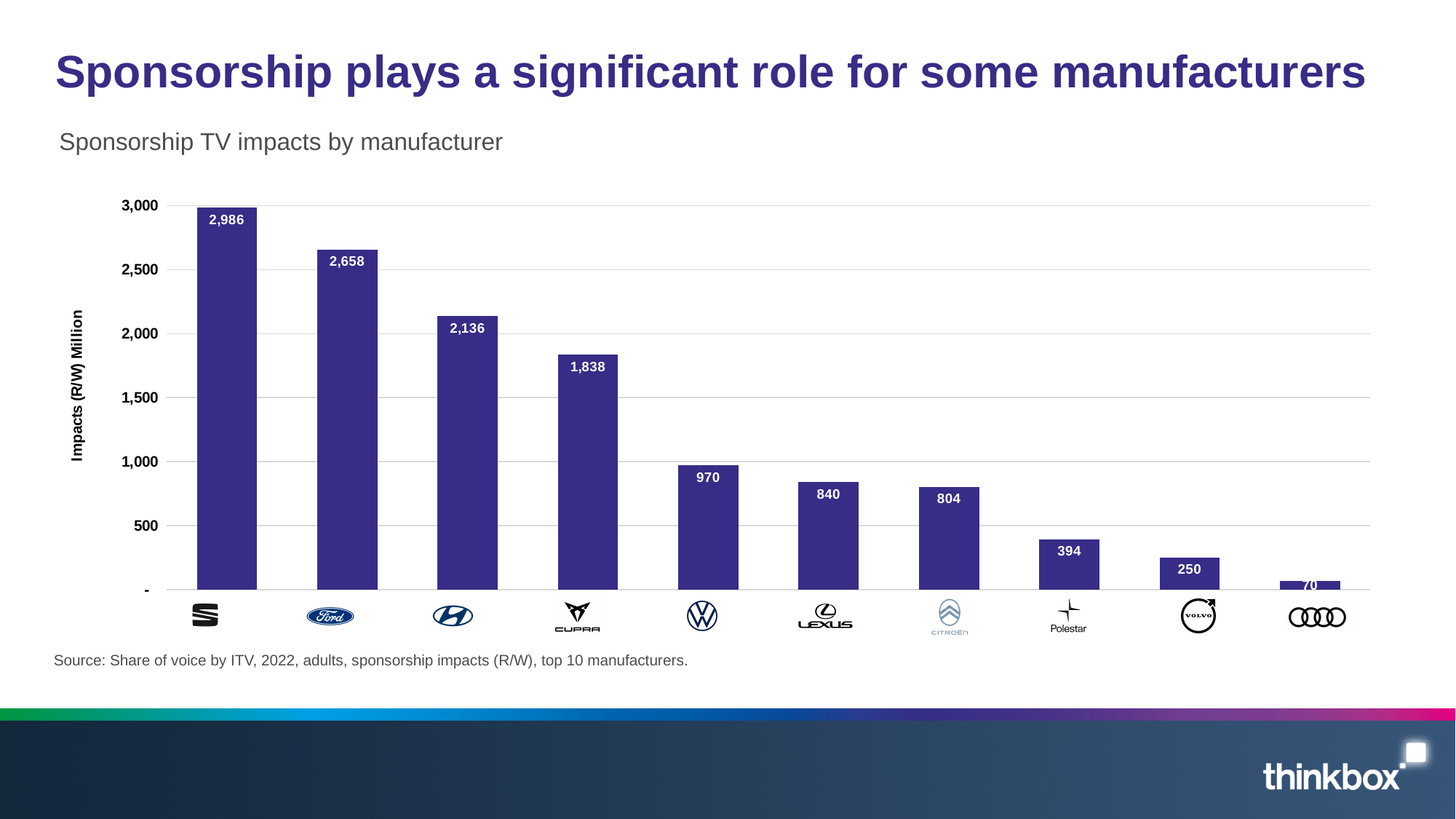
What is the value for Lexus? 840 What is the value for Cupra? 1,838 What is the value for Ford? 2,658 What is the label on the vertical axis of the chart? Impacts (R/W) Million What type of chart is shown on the slide? bar chart Do the values rise or fall from left to right across the chart? fall How many manufacturers are shown in the chart? 10 What is the value of the first (leftmost) bar in the chart? 2,986 Which has a higher value, Lexus or Citroën? Lexus What is the value for Polestar? 394 What is the difference between the values for Ford and Cupra? 820 What is the value for Volvo? 250